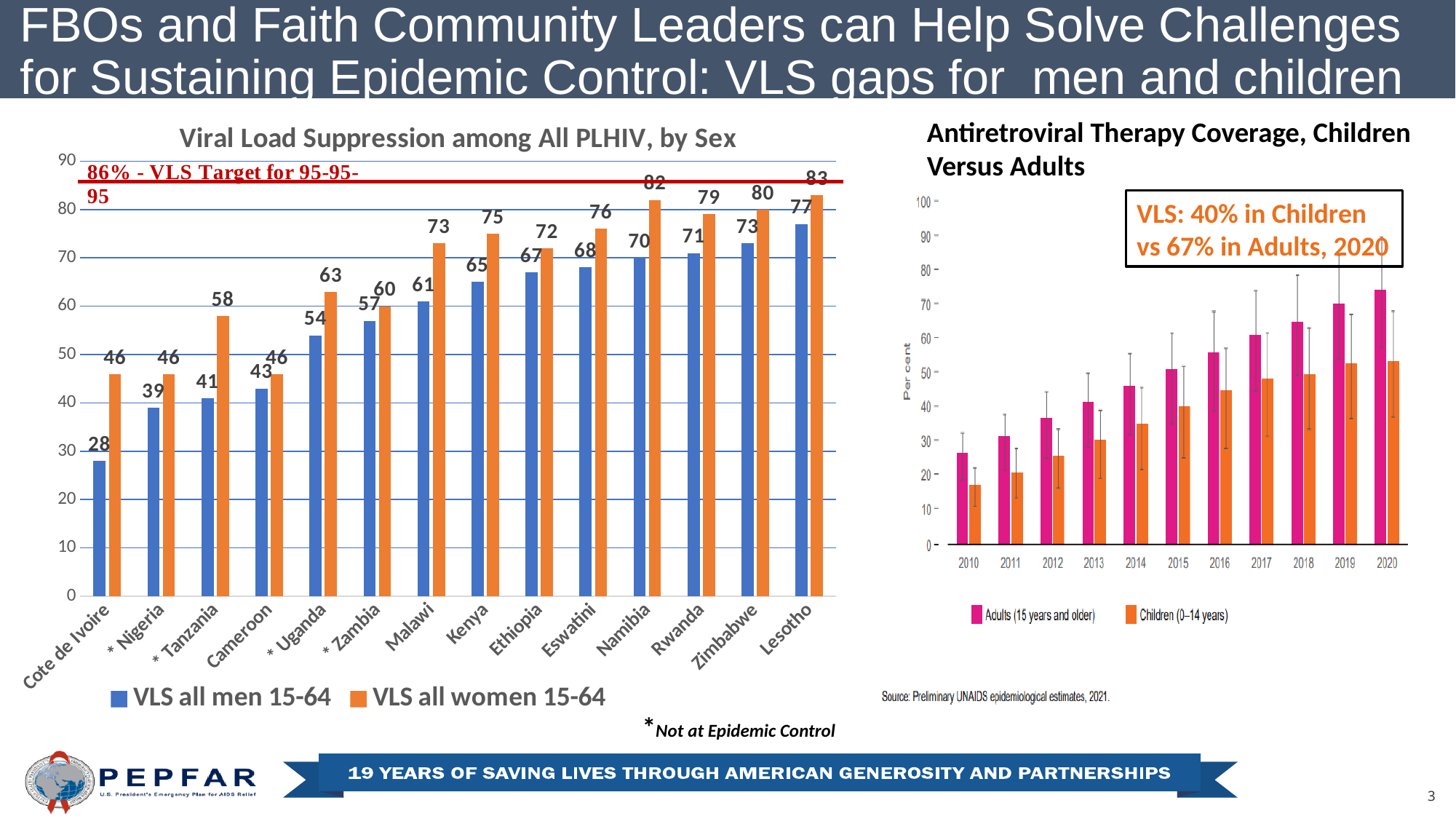
In the 'Viral Load Suppression among All PLHIV, by Sex' chart, what is the VLS value for all men 15-64 in Cote de Ivoire? 28 In the 'Viral Load Suppression among All PLHIV, by Sex' chart, which country has the highest VLS value for all women 15-64? Lesotho In the 'Viral Load Suppression among All PLHIV, by Sex' chart, what is the difference between the VLS values for women and men in Tanzania? 17 How many years are shown on the x axis of the 'Antiretroviral Therapy Coverage, Children Versus Adults' chart? 11 What type of chart is the 'Antiretroviral Therapy Coverage, Children Versus Adults' chart? Bar chart How many countries are shown in the 'Viral Load Suppression among All PLHIV, by Sex' chart? 14 In the 'Viral Load Suppression among All PLHIV, by Sex' chart, what is the VLS value for all women 15-64 in Namibia? 82 In the 'Antiretroviral Therapy Coverage, Children Versus Adults' chart, do the values for Adults (15 years and older) rise or fall from 2010 to 2020? Rise In the 'Antiretroviral Therapy Coverage, Children Versus Adults' chart, is the value for Children (0-14 years) in 2010 greater or less than 20? less In the 'Viral Load Suppression among All PLHIV, by Sex' chart, which country has the lowest VLS value for all men 15-64? Cote de Ivoire How many series does the legend of the 'Viral Load Suppression among All PLHIV, by Sex' chart list? 2 In the 'Viral Load Suppression among All PLHIV, by Sex' chart, which is larger: the VLS value for men in Zimbabwe or the VLS value for men in Lesotho? Lesotho